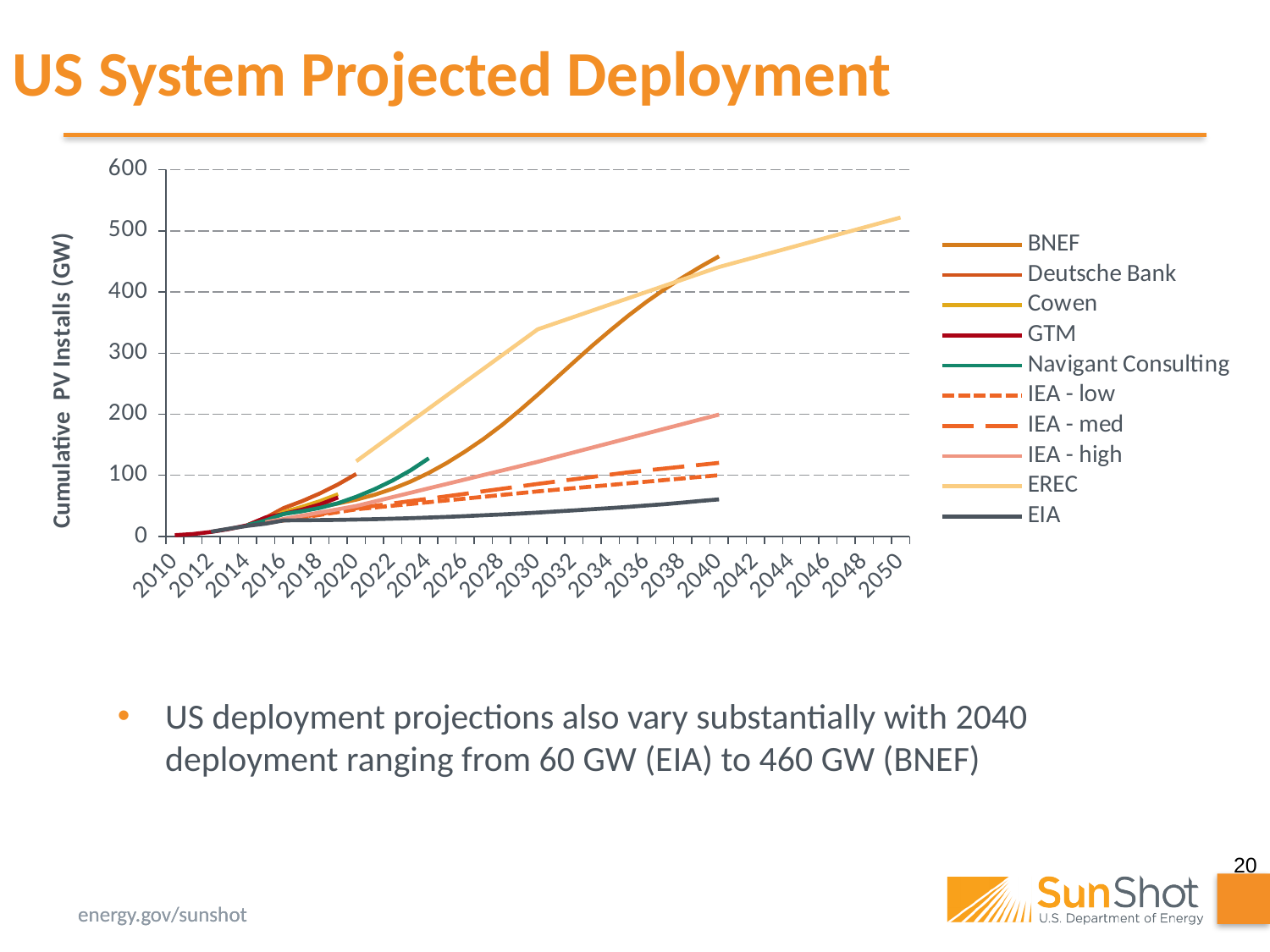
Is the EREC value for 2050 greater or less than 500? greater According to the slide, what is the projected 2040 deployment for EIA? 60 GW Is the EIA value for 2040 greater or less than 100? less Is the Navigant Consulting value at the end of its line (around 2024) greater or less than 100? greater According to the slide, what is the projected 2040 deployment for BNEF? 460 GW Which series has the highest projected value in 2040? BNEF Which series has the lowest projected value in 2040? EIA What is the label of the y axis? Cumulative PV Installs (GW) What type of chart is shown on the slide? line chart What is the difference between the BNEF and EIA projections for 2040? 400 GW Do the projected values generally rise or fall over time along the x axis? rise How many series does the legend list? 10